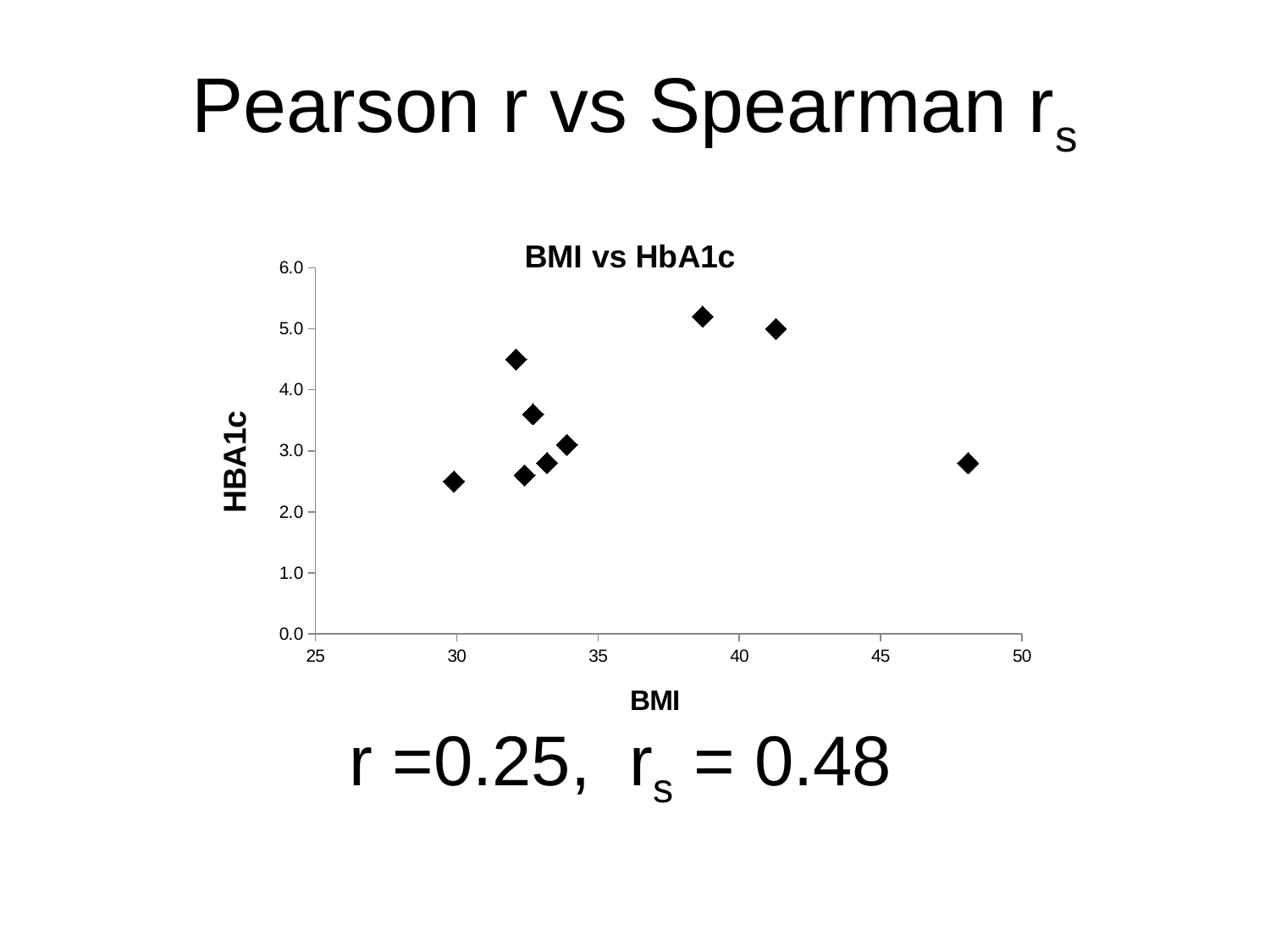
How many points have a BMI less than 35? 6 What kind of chart is shown on the slide? scatter plot What is the title of the chart? BMI vs HbA1c Is the BMI of the rightmost point greater or less than 45? greater What values of Pearson r and Spearman rs are given below the chart? r = 0.25, rs = 0.48 How many points have a BMI greater than 40? 2 Is the HbA1c of the leftmost point (BMI near 30) greater or less than 3.0? less Is the HbA1c of the rightmost point (BMI near 48) greater or less than 3.0? less How many data points are plotted in the BMI vs HbA1c chart? 9 Which has the higher HbA1c: the point at BMI near 30 or the point at BMI near 39? the point at BMI near 39